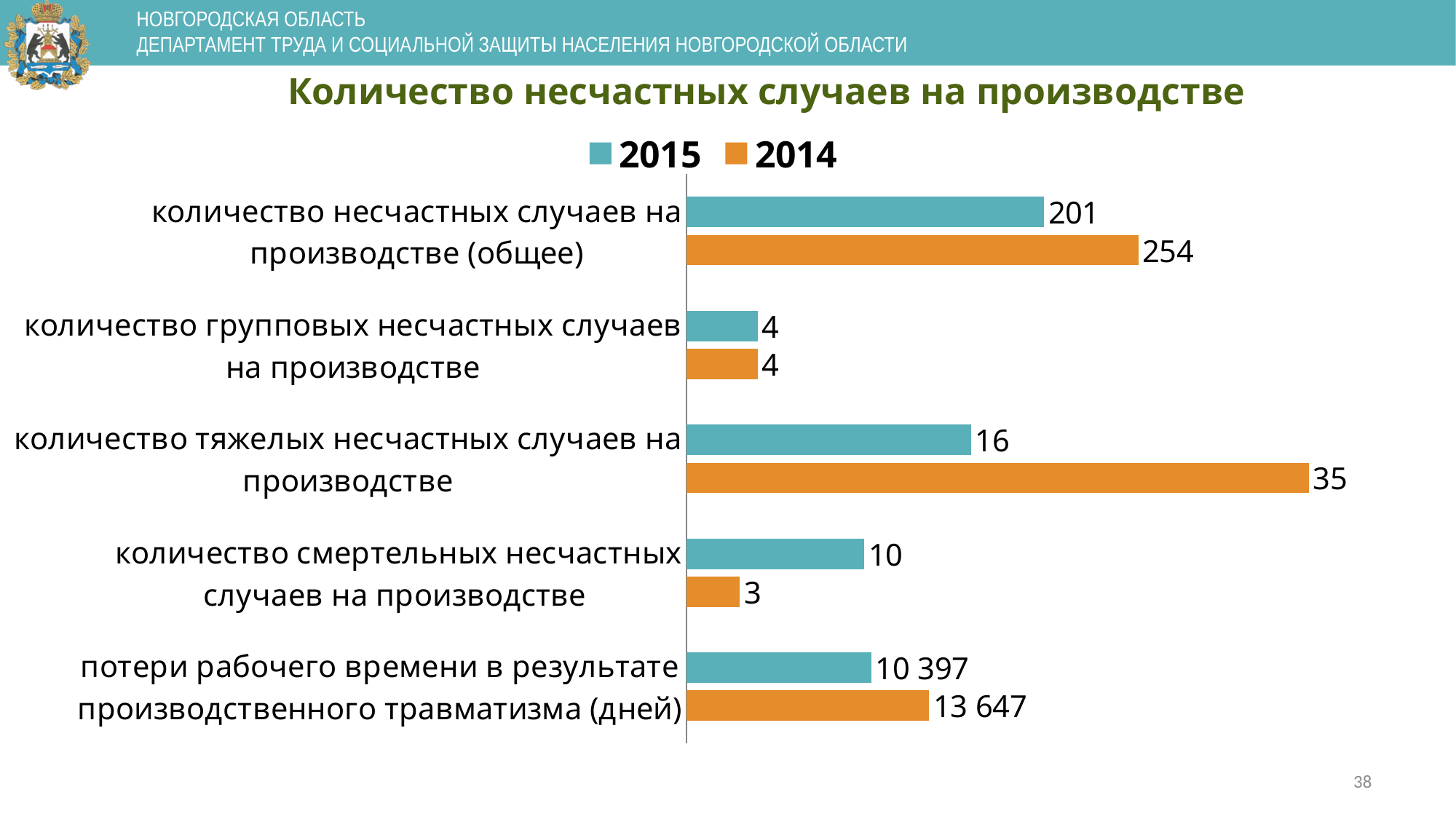
What is the 2015 value for "количество смертельных несчастных случаев на производстве"? 10 How many series does the legend list? 2 What is the 2015 value for "количество несчастных случаев на производстве (общее)"? 201 What is the title of the chart? Количество несчастных случаев на производстве What kind of chart is shown on the slide? Bar chart Which year has the larger value for "количество смертельных несчастных случаев на производстве", 2015 or 2014? 2015 How many categories are shown on the chart? 5 Which year has the larger value for "потери рабочего времени в результате производственного травматизма (дней)", 2015 or 2014? 2014 What is the 2014 value for "количество тяжелых несчастных случаев на производстве"? 35 What is the difference between the 2014 and 2015 values for "количество тяжелых несчастных случаев на производстве"? 19 What is the 2014 value for "потери рабочего времени в результате производственного травматизма (дней)"? 13 647 What is the difference between the 2014 and 2015 values for "количество несчастных случаев на производстве (общее)"? 53